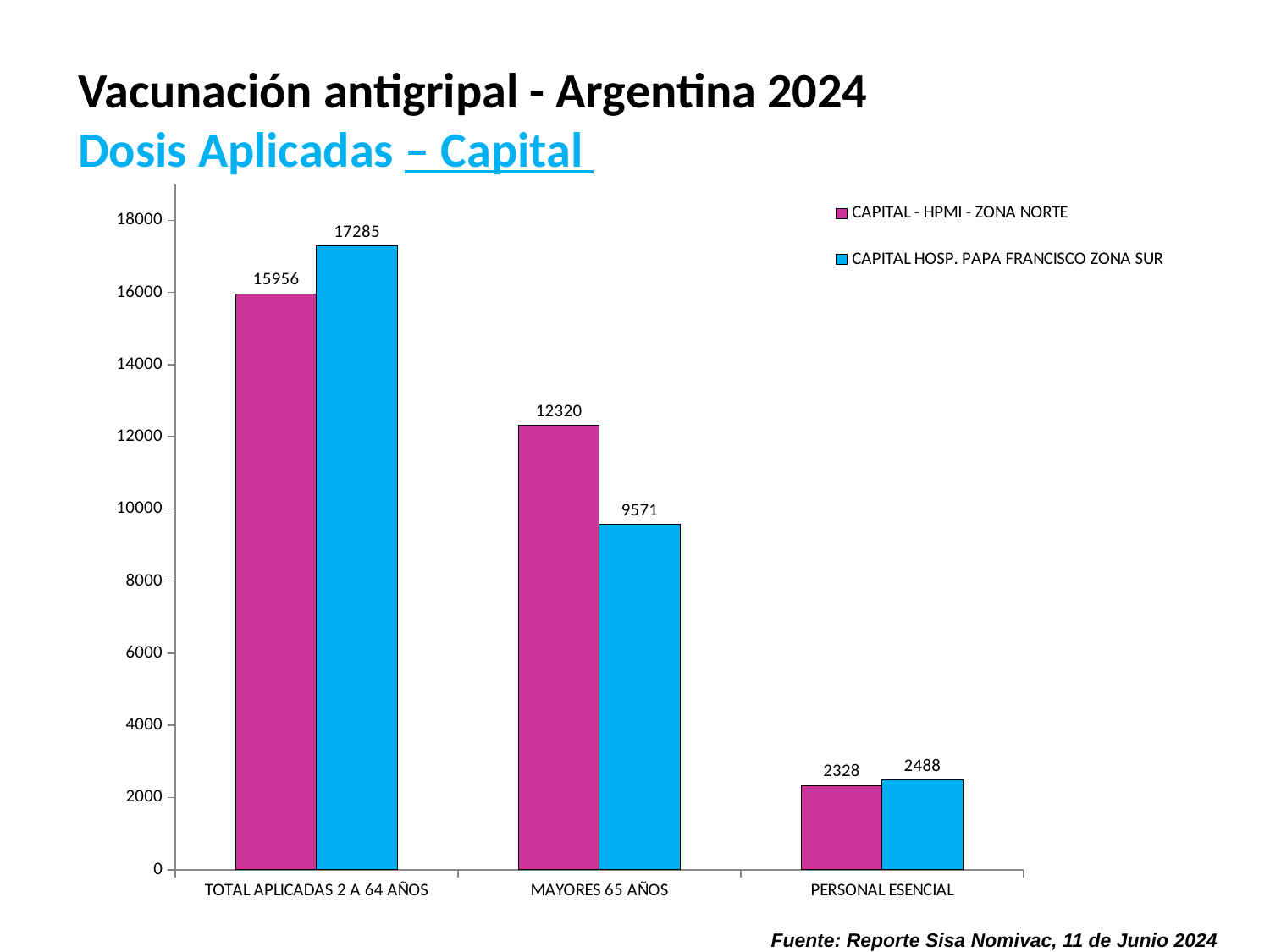
How many categories are shown on the x axis? 3 Is the value for CAPITAL - HPMI - ZONA NORTE in MAYORES 65 AÑOS greater or less than 12000? greater What kind of chart is shown on the slide? bar chart How many series does the legend list? 2 Which category has the lowest value for CAPITAL - HPMI - ZONA NORTE? PERSONAL ESENCIAL Which category has the highest value for CAPITAL HOSP. PAPA FRANCISCO ZONA SUR? TOTAL APLICADAS 2 A 64 AÑOS What is the value for CAPITAL - HPMI - ZONA NORTE in the TOTAL APLICADAS 2 A 64 AÑOS category? 15956 What is the difference between CAPITAL HOSP. PAPA FRANCISCO ZONA SUR and CAPITAL - HPMI - ZONA NORTE in the TOTAL APLICADAS 2 A 64 AÑOS category? 1329 What is the difference between the two series in the MAYORES 65 AÑOS category? 2749 What is the value for CAPITAL HOSP. PAPA FRANCISCO ZONA SUR in the PERSONAL ESENCIAL category? 2488 What is the value for CAPITAL HOSP. PAPA FRANCISCO ZONA SUR in the MAYORES 65 AÑOS category? 9571 In the PERSONAL ESENCIAL category, which series has the larger value? CAPITAL HOSP. PAPA FRANCISCO ZONA SUR